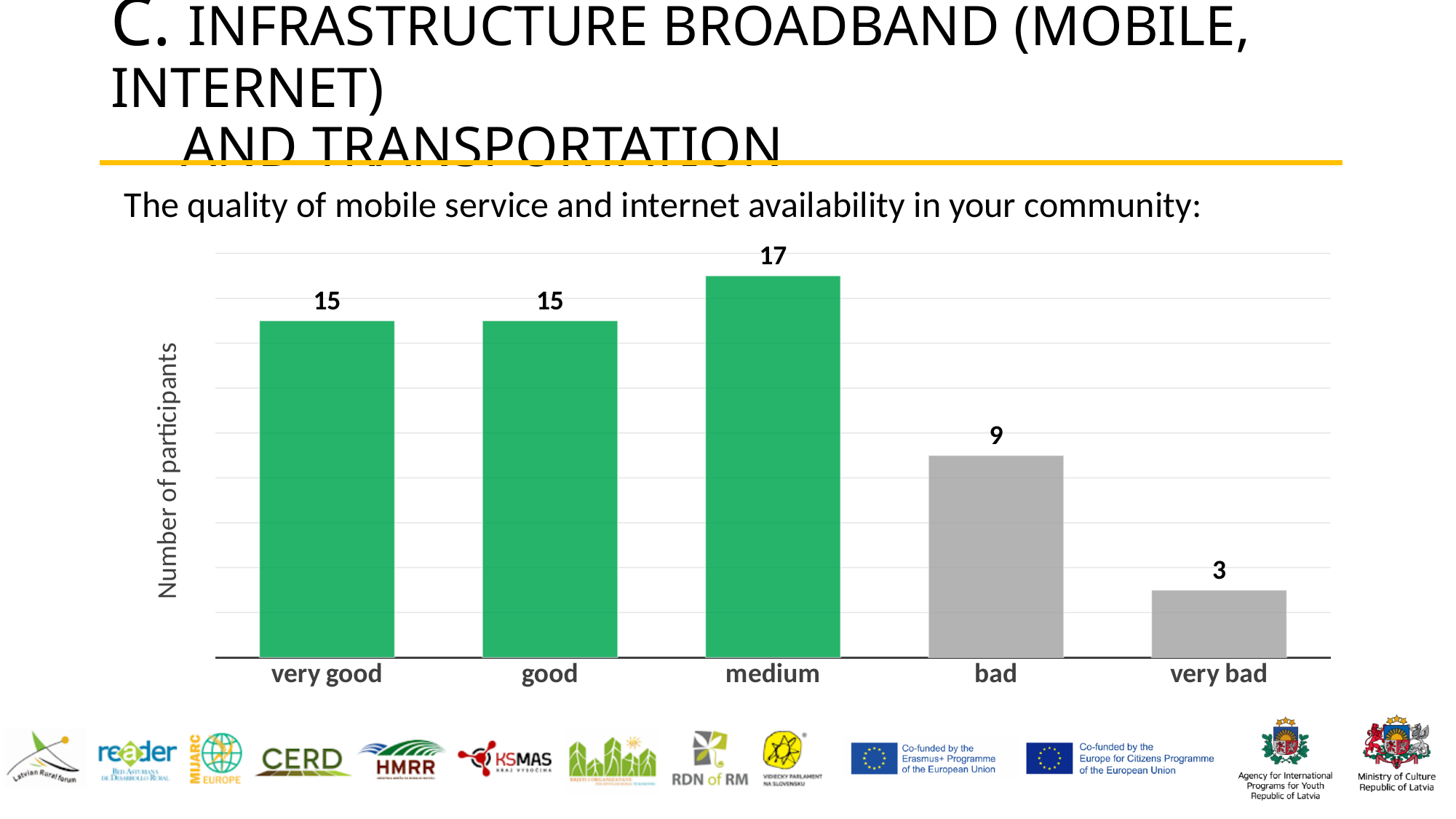
What is the difference between the number of participants who rated "medium" and those who rated "bad"? 8 Which rating category has the highest number of participants? medium What is the label of the vertical axis of the chart? Number of participants Which rating categories are shown with grey bars rather than green bars? bad and very bad How many participants rated the quality of mobile service and internet availability as "bad"? 9 What is the difference between the number of participants who rated "bad" and those who rated "very bad"? 6 What kind of chart is used to show the quality of mobile service and internet availability? bar chart Which has more participants: "good" or "bad"? good How many rating categories are shown on the x axis of the chart? 5 How many participants rated the quality of mobile service and internet availability as "medium"? 17 Which rating category has the lowest number of participants? very bad How many participants rated the quality of mobile service and internet availability as "very bad"? 3